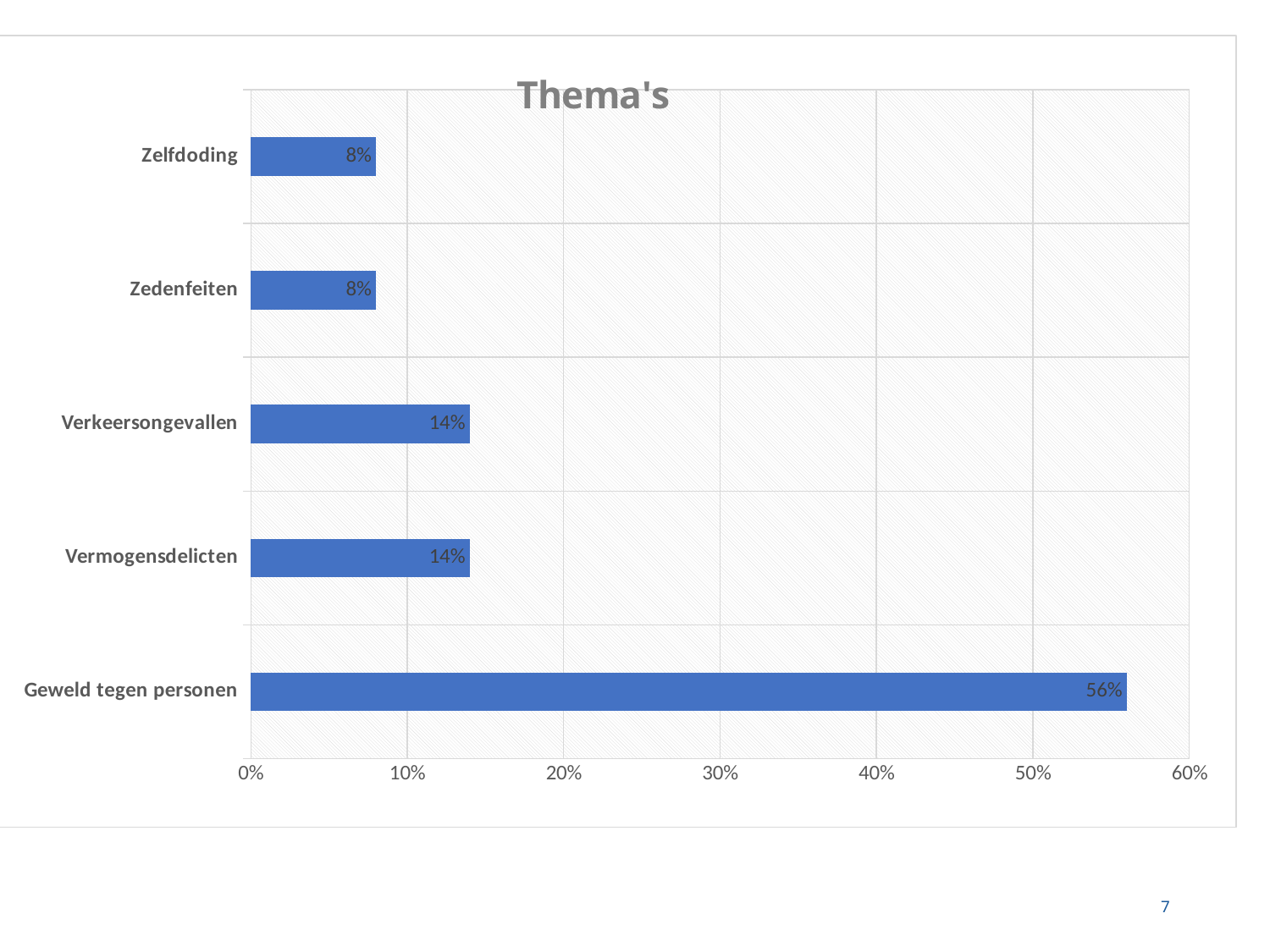
What is the value for Zelfdoding? 8% What is the value for Verkeersongevallen? 14% What is the difference between the values for Vermogensdelicten and Zedenfeiten? 6% What is the difference between the values for Geweld tegen personen and Verkeersongevallen? 42% What is the title of the chart? Thema's What is the value for Geweld tegen personen? 56% How many categories are shown in the chart? 5 What kind of chart is shown on the slide? bar chart Which is larger, the value for Verkeersongevallen or the value for Zedenfeiten? Verkeersongevallen Is the value for Geweld tegen personen greater or less than 50%? greater Which category has the highest value? Geweld tegen personen What is the value for Vermogensdelicten? 14%